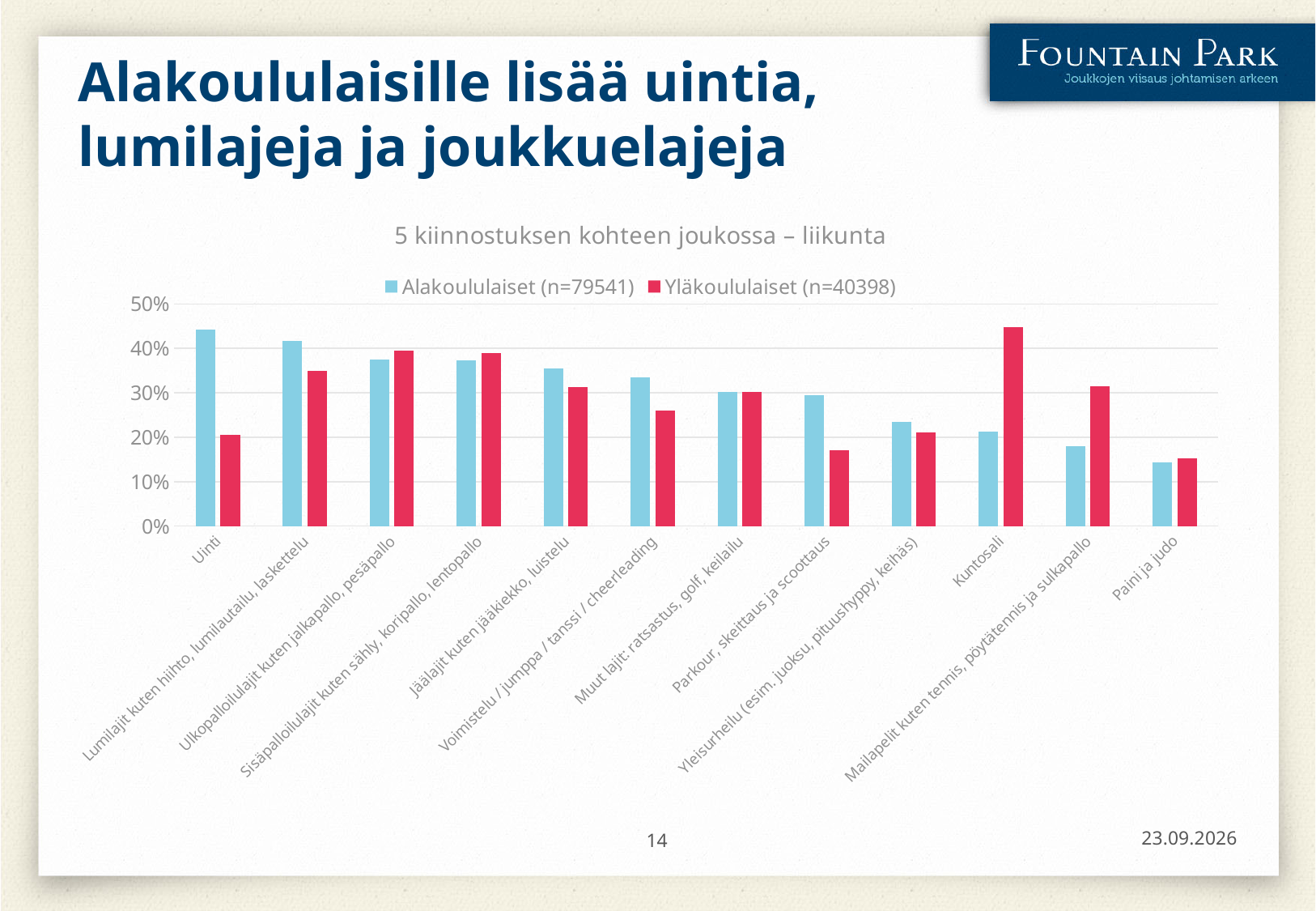
For Kuntosali, which series has the larger value, Alakoululaiset (n=79541) or Yläkoululaiset (n=40398)? Yläkoululaiset (n=40398) How many series does the legend list? 2 What kind of chart is shown on the slide? bar chart Which category has the highest value for Yläkoululaiset (n=40398)? Kuntosali Which category has the highest value for Alakoululaiset (n=79541)? Uinti Is the value for Uinti for Alakoululaiset (n=79541) greater or less than 40%? greater For Uinti, which series has the larger value, Alakoululaiset (n=79541) or Yläkoululaiset (n=40398)? Alakoululaiset (n=79541) Which category has the lowest value for Alakoululaiset (n=79541)? Paini ja judo Is the value for Kuntosali for Yläkoululaiset (n=40398) greater or less than 40%? greater Is the value for Parkour, skeittaus ja scoottaus for Yläkoululaiset (n=40398) greater or less than 20%? less What is the title of the chart? 5 kiinnostuksen kohteen joukossa – liikunta How many categories are shown on the x axis? 12